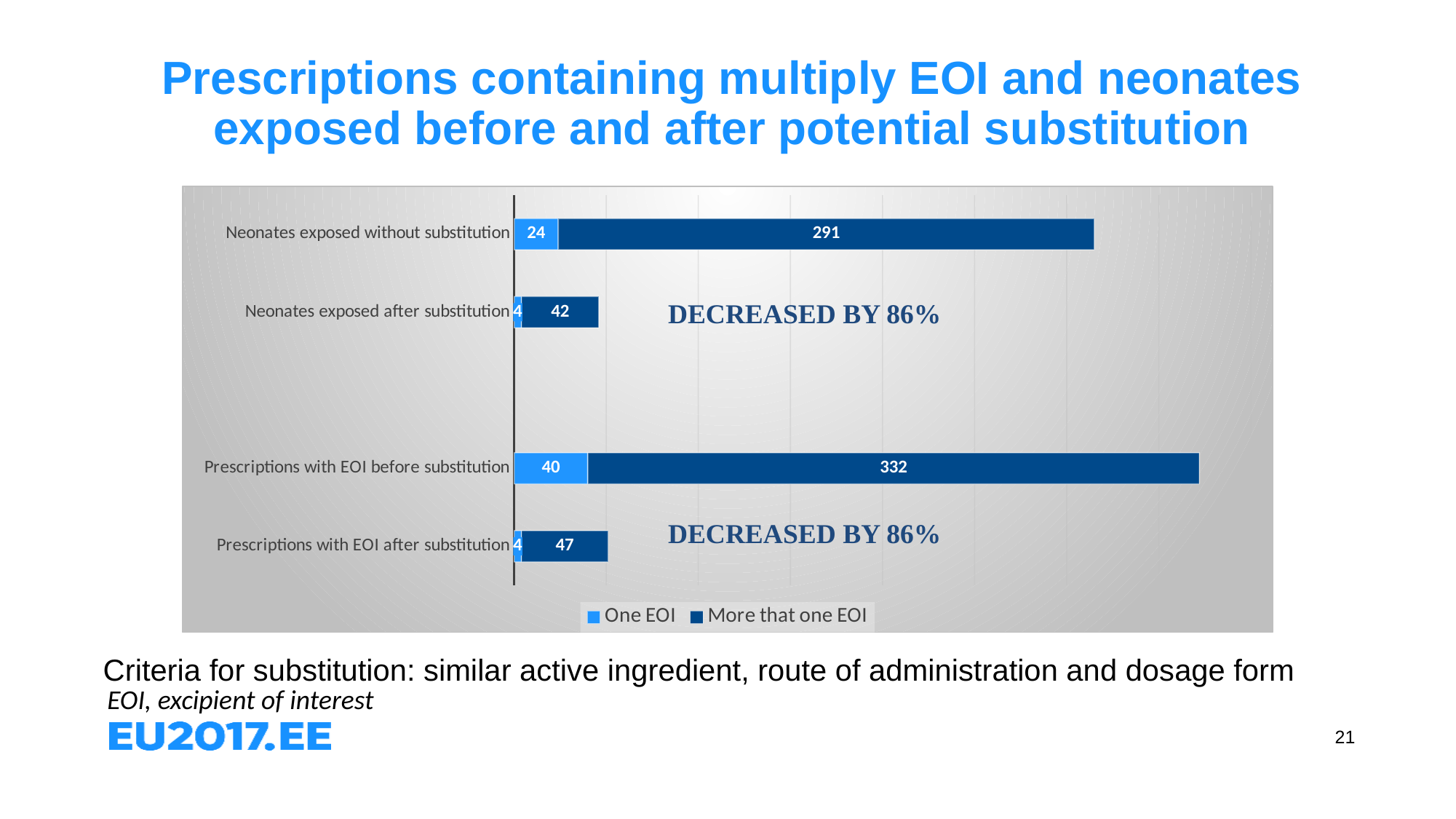
How many categories are plotted in the chart? 4 What kind of chart is shown on the slide? Stacked bar chart What is the 'More that one EOI' value for 'Neonates exposed without substitution'? 291 What is the 'One EOI' value for 'Neonates exposed after substitution'? 4 What is the total of the stacked bar for 'Neonates exposed without substitution'? 315 Which series is shown in the darker blue colour in the legend? More that one EOI What is the difference between the 'More that one EOI' values for 'Prescriptions with EOI before substitution' and 'Prescriptions with EOI after substitution'? 285 Which category has the highest 'More that one EOI' value? Prescriptions with EOI before substitution How many series does the legend list? 2 What is the 'One EOI' value for 'Prescriptions with EOI before substitution'? 40 What is the 'More that one EOI' value for 'Prescriptions with EOI after substitution'? 47 Which category has the lowest 'More that one EOI' value? Neonates exposed after substitution